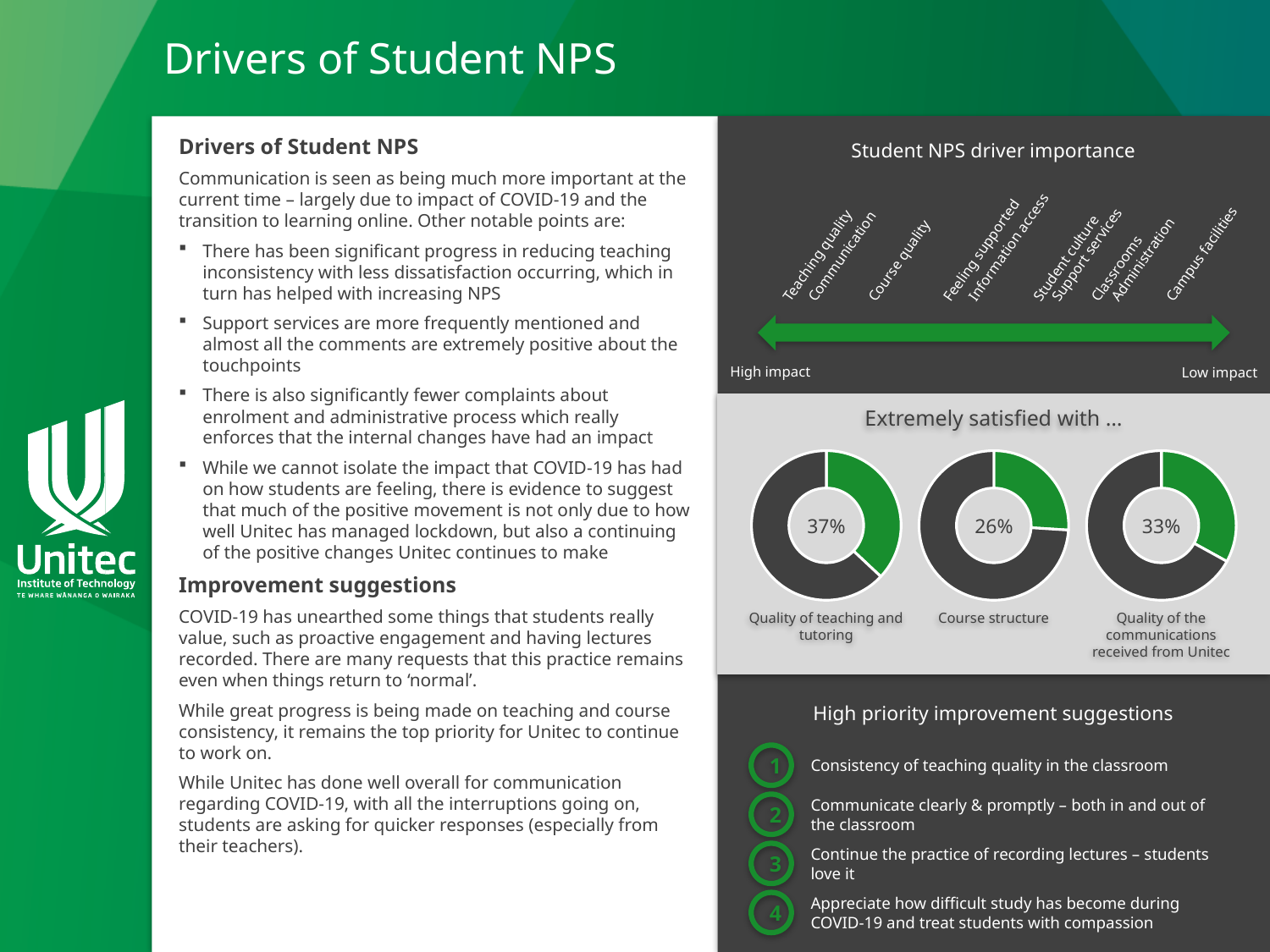
In the 'Extremely satisfied with ...' charts, what percentage of students are extremely satisfied with course structure? 26% Among the 'Extremely satisfied with ...' charts, which item has the highest percentage? Quality of teaching and tutoring In the 'Extremely satisfied with ...' charts, what is the difference in percentage points between quality of teaching and tutoring and course structure? 11 In the 'Extremely satisfied with ...' charts, what is the difference in percentage points between quality of the communications received from Unitec and course structure? 7 In the 'Extremely satisfied with ...' charts, what percentage of students are extremely satisfied with quality of teaching and tutoring? 37% In the 'Extremely satisfied with ...' charts, what percentage of students are extremely satisfied with the quality of the communications received from Unitec? 33% In the 'Student NPS driver importance' chart, which driver is shown as having the lowest impact? Campus facilities In the 'Student NPS driver importance' chart, which driver is shown as having the highest impact? Teaching quality Among the 'Extremely satisfied with ...' charts, which item has the lowest percentage? Course structure What type of chart is used under 'Extremely satisfied with ...'? Donut chart How many donut charts are shown under 'Extremely satisfied with ...'? 3 In the 'Extremely satisfied with ...' charts, which is larger: the percentage for course structure or for quality of the communications received from Unitec? Quality of the communications received from Unitec